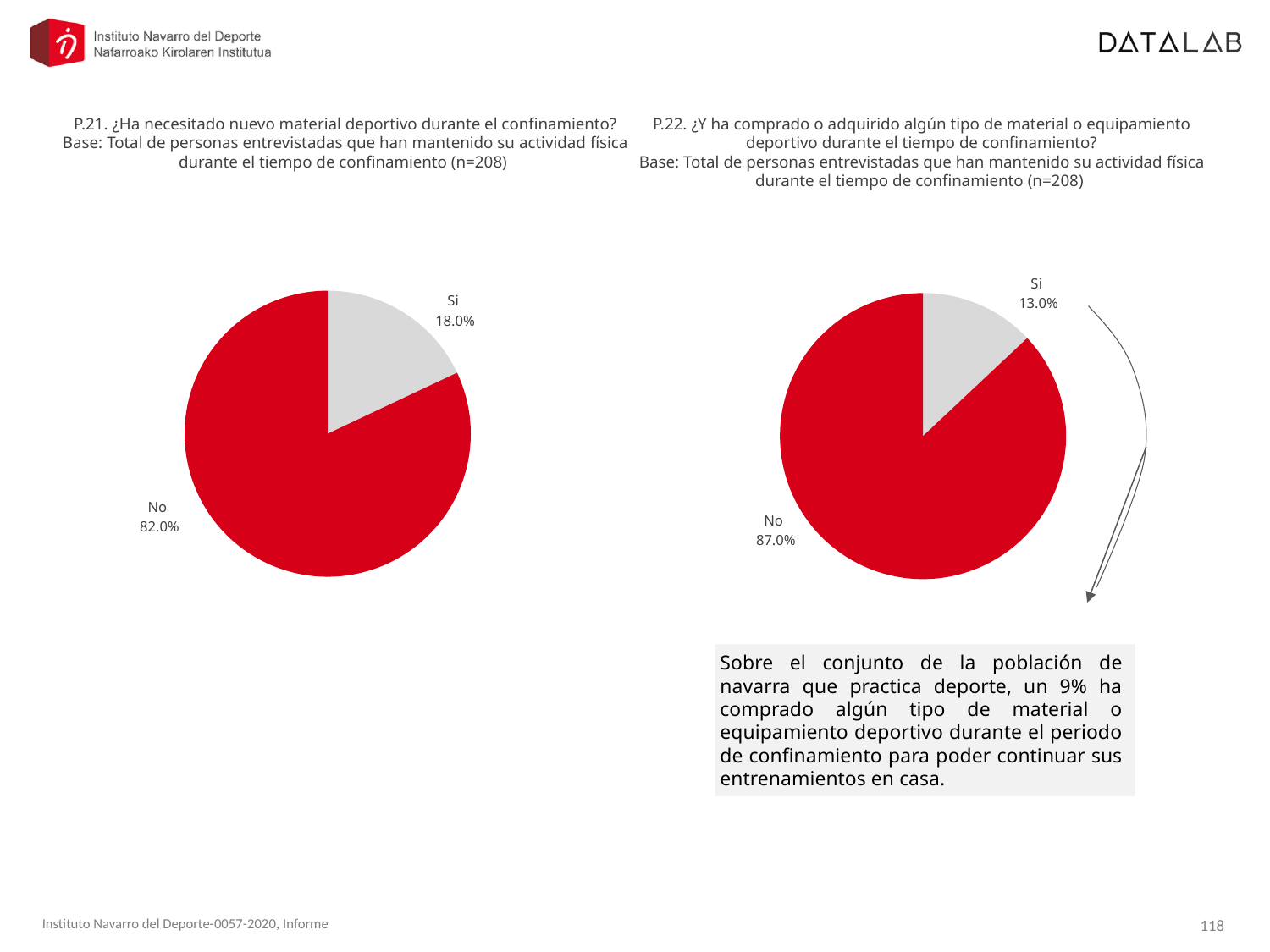
In the right chart (P.22), what is the difference in percentage points between 'No' and 'Si'? 74.0 In the left chart (P.21), what is the difference in percentage points between 'No' and 'Si'? 64.0 Which chart has the larger 'Si' share, the left chart (P.21) or the right chart (P.22)? The left chart (P.21) In the left chart (P.21), what percentage of respondents answered 'Si'? 18.0% In the left chart (P.21), which category has the largest slice? No What type of chart is used on the left side of the slide (P.21)? Pie chart In the right chart (P.22), what colour is the 'No' slice? Red In the right chart (P.22), what percentage of respondents answered 'Si'? 13.0% In the right chart (P.22), which category has the smallest slice? Si In the left chart (P.21), what percentage of respondents answered 'No'? 82.0% How many categories are shown in the right chart (P.22)? 2 In the right chart (P.22), what percentage of respondents answered 'No'? 87.0%